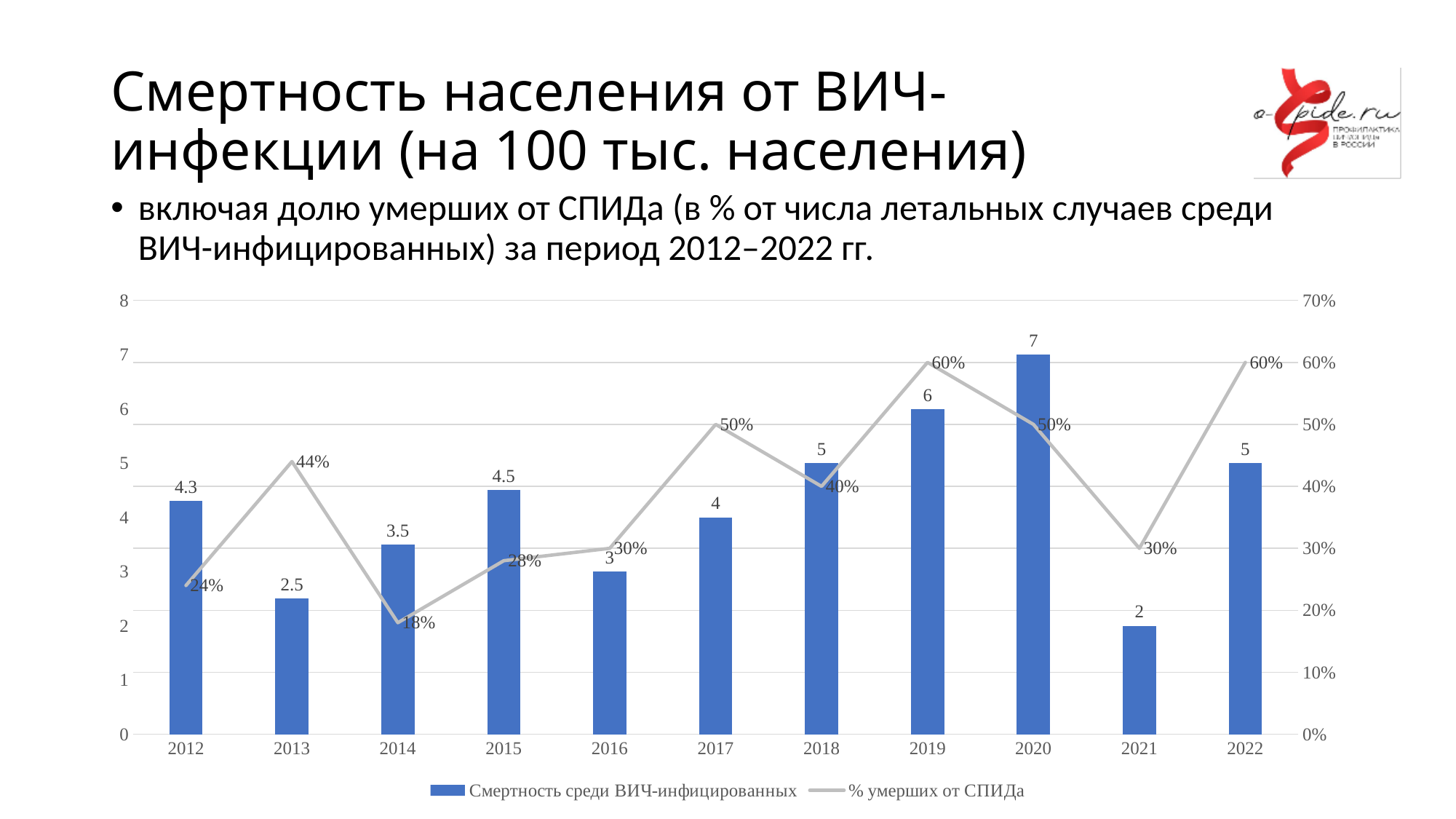
What is the mortality among HIV-infected (Смертность среди ВИЧ-инфицированных) value for 2019? 6 What percentage of deaths were from AIDS (% умерших от СПИДа) in 2014? 18% Which year has the lowest bar for mortality among HIV-infected? 2021 Which year has a larger mortality bar value, 2015 or 2016? 2015 What is the value of the bar for 2012 in the chart? 4.3 What kinds of chart are combined in this slide's chart? Bar chart and line chart How many series does the chart legend list? 2 Which year has the highest bar for mortality among HIV-infected? 2020 What is the difference between the mortality bar values for 2020 and 2021? 5 How many years are shown on the x axis of the chart? 11 In which year is the share of deaths from AIDS (% умерших от СПИДа) the lowest? 2014 What is the difference in the share of deaths from AIDS between 2013 and 2012? 20%